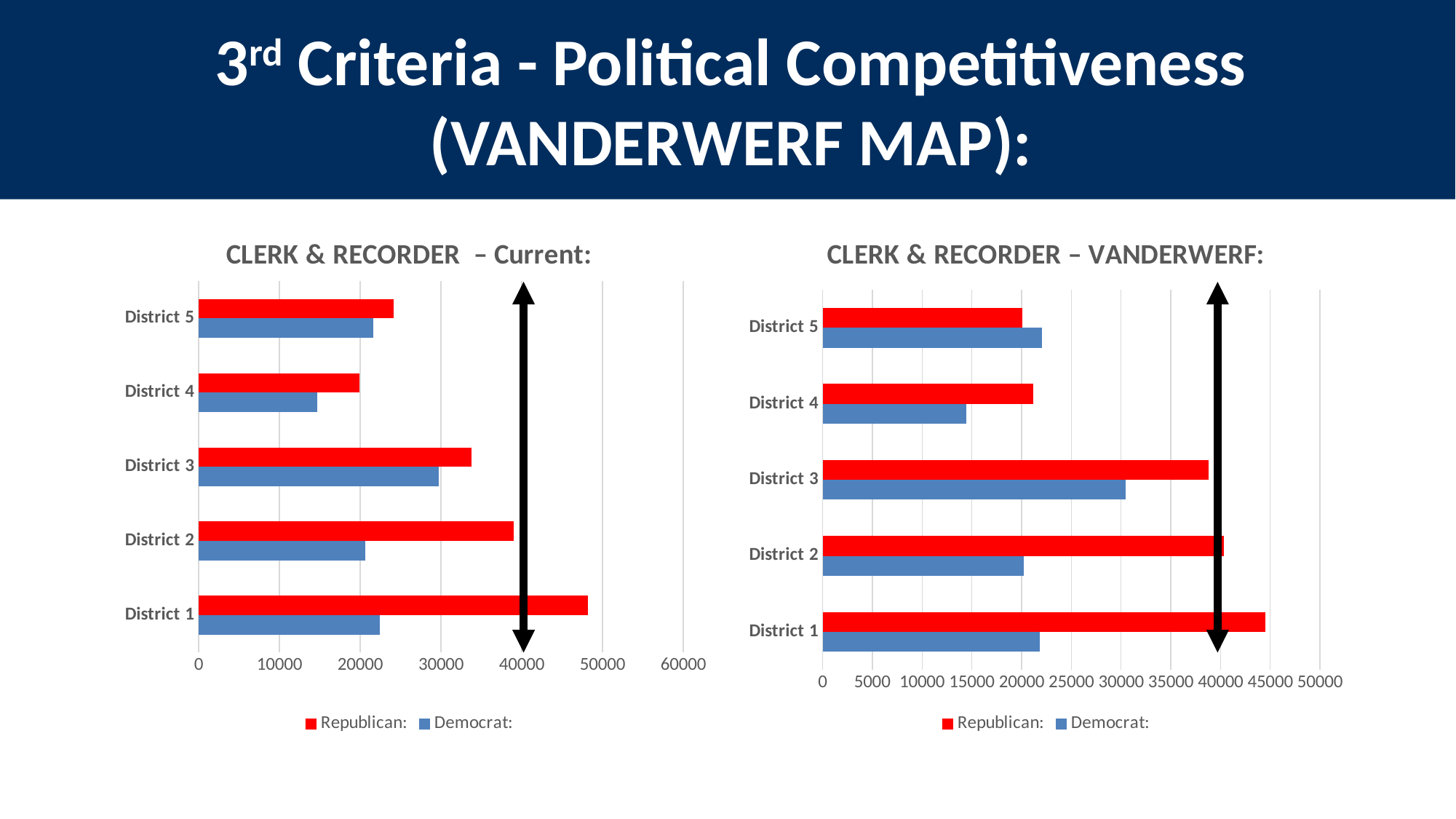
How many series does the legend of the CLERK & RECORDER – Current chart list? 2 In the CLERK & RECORDER – VANDERWERF chart, is the Republican value for District 1 greater or less than 40000? greater In the CLERK & RECORDER – Current chart, which district has the lowest Democrat value? District 4 In the CLERK & RECORDER – Current chart, is the Republican value for District 3 greater or less than 30000? greater In the CLERK & RECORDER – Current chart, which is larger for District 2, the Republican or the Democrat value? Republican In the CLERK & RECORDER – VANDERWERF chart, what colour represents the Republican series? red In the CLERK & RECORDER – Current chart, is the Republican value for District 1 greater or less than 40000? greater What kind of chart is the CLERK & RECORDER – Current chart on the left? bar chart In the CLERK & RECORDER – VANDERWERF chart, which is larger for District 5, the Republican or the Democrat value? Democrat In the CLERK & RECORDER – Current chart, which district has the highest Republican value? District 1 In the CLERK & RECORDER – VANDERWERF chart, which district has the highest Republican value? District 1 How many districts are shown on the CLERK & RECORDER – VANDERWERF chart? 5